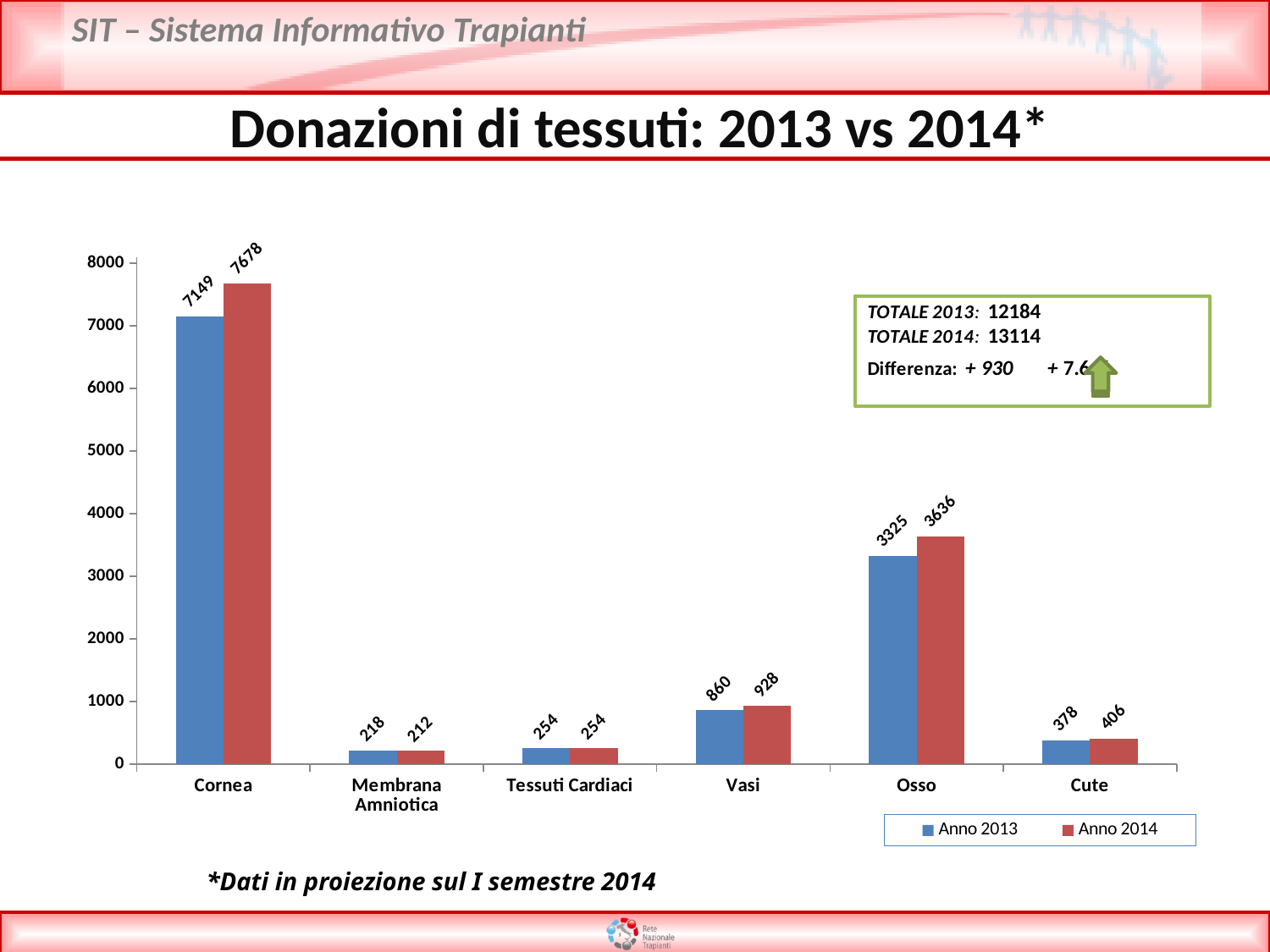
How many categories are shown on the x axis? 6 What is the value for Cornea in Anno 2014? 7678 Which category has the highest value in Anno 2013? Cornea What is the value for Osso in Anno 2013? 3325 Which is larger for Cute: the Anno 2013 value or the Anno 2014 value? Anno 2014 Is the value for Vasi in Anno 2013 greater or less than 1000? less What kind of chart is shown on the slide? bar chart What is the title of the chart on the slide? Donazioni di tessuti: 2013 vs 2014* Which category has the lowest value in Anno 2014? Membrana Amniotica How many series does the legend list? 2 What is the value for Vasi in Anno 2014? 928 What is the difference between the Anno 2014 and Anno 2013 values for Osso? 311